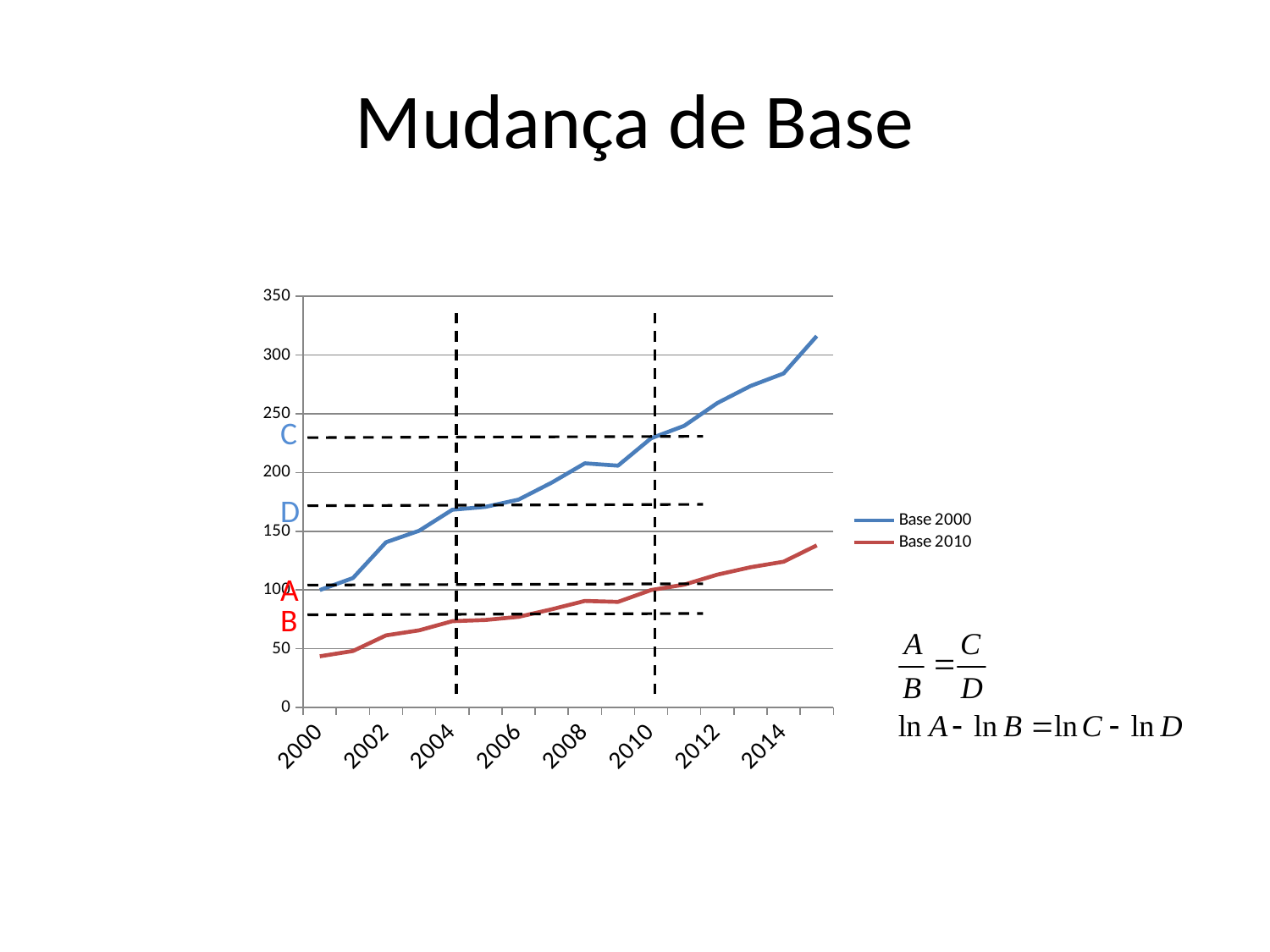
Which series reaches the highest value on the chart? Base 2000 Is the value of Base 2010 in 2000 greater or less than 50? less Does the Base 2010 series generally rise or fall along the x axis? rise Is the value of Base 2010 in 2014 greater or less than 150? less What are the two series named in the legend? Base 2000 and Base 2010 Is the value of Base 2000 in 2006 greater or less than 150? greater How many series does the legend list? 2 What is the title of the slide containing the chart? Mudança de Base In 2014, which series has the larger value, Base 2000 or Base 2010? Base 2000 Does the Base 2000 series generally rise or fall from 2000 to the end of the chart? rise What kind of chart is shown on the slide? line chart